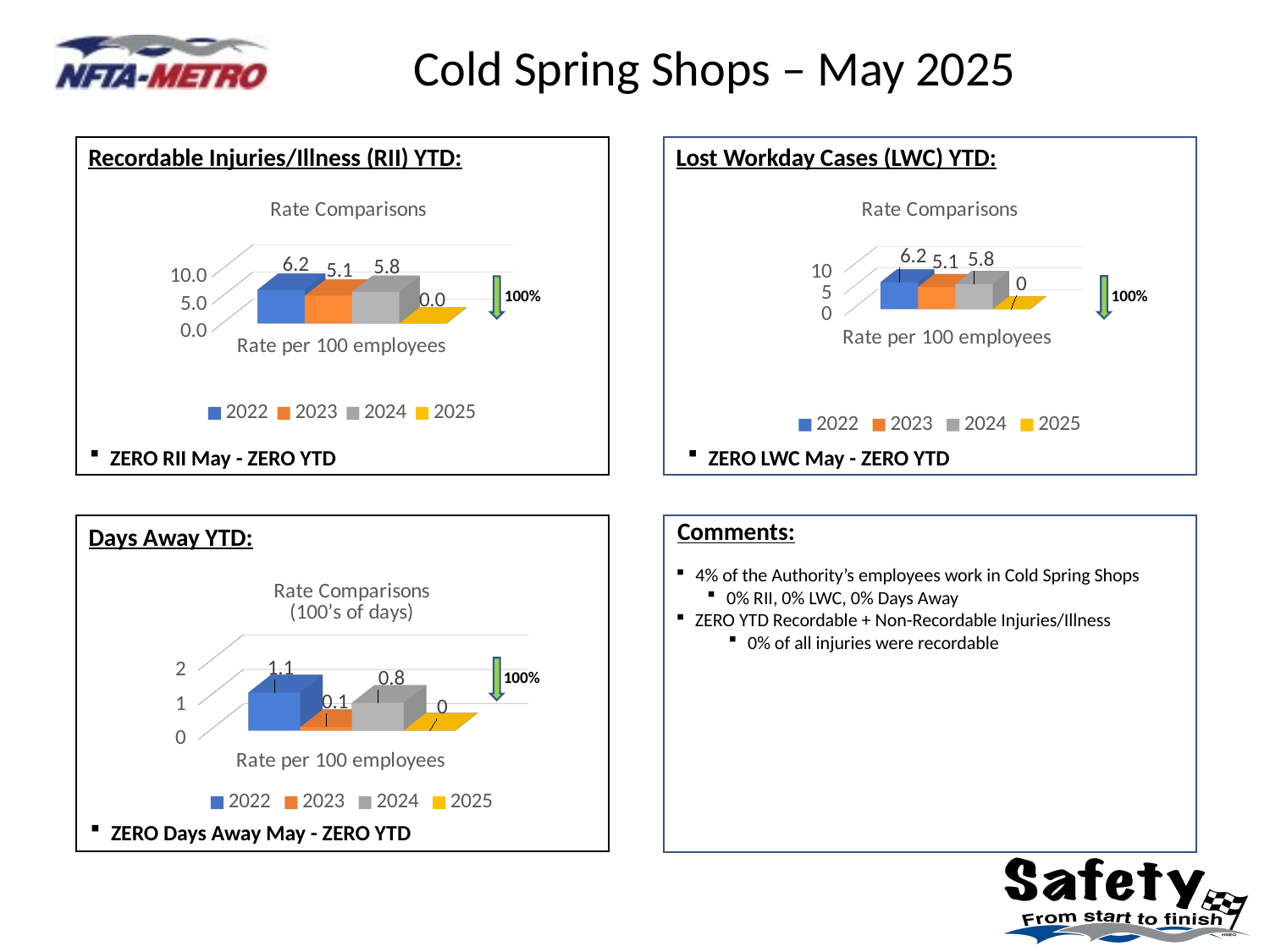
In the Recordable Injuries/Illness (RII) YTD chart, what is the value for 2022? 6.2 How many series does the legend list in the Lost Workday Cases (LWC) YTD chart? 4 What kind of chart is the Days Away YTD chart? bar chart In the Recordable Injuries/Illness (RII) YTD chart, what is the value for 2025? 0.0 In the Recordable Injuries/Illness (RII) YTD chart, what is the difference between the 2022 and 2023 values? 1.1 In the Lost Workday Cases (LWC) YTD chart, is the value for 2023 larger or smaller than the value for 2024? smaller In the Lost Workday Cases (LWC) YTD chart, which year has the lowest value? 2025 In the Days Away YTD chart, which year has the highest value? 2022 In the Recordable Injuries/Illness (RII) YTD chart, which year has the highest value? 2022 In the Days Away YTD chart, what is the difference between the 2022 and 2024 values? 0.3 In the Days Away YTD chart, what is the value for 2023? 0.1 In the Lost Workday Cases (LWC) YTD chart, what is the value for 2024? 5.8